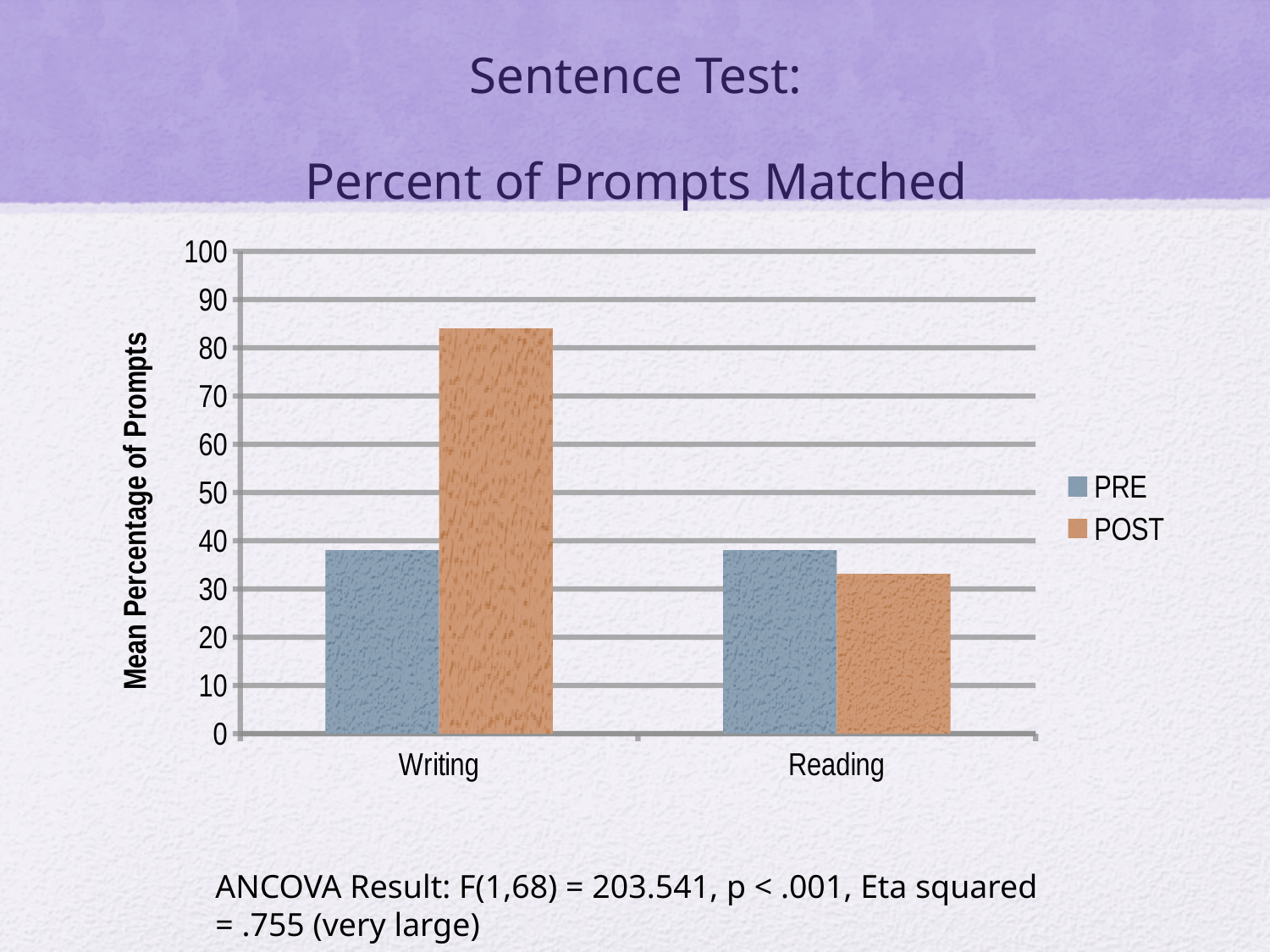
For Reading, which is larger, PRE or POST? PRE How many series does the legend list? 2 Is the PRE value for Writing greater or less than 40? less Which bar is the highest in the chart? Writing POST Is the POST value for Writing greater or less than 80? greater How many categories are shown on the x axis? 2 Is the POST value for Reading greater or less than 30? greater What are the two series named in the legend? PRE and POST What kind of chart is shown on the slide? bar chart For Writing, which is larger, PRE or POST? POST Which bar is the lowest in the chart? Reading POST What is the label of the y axis? Mean Percentage of Prompts